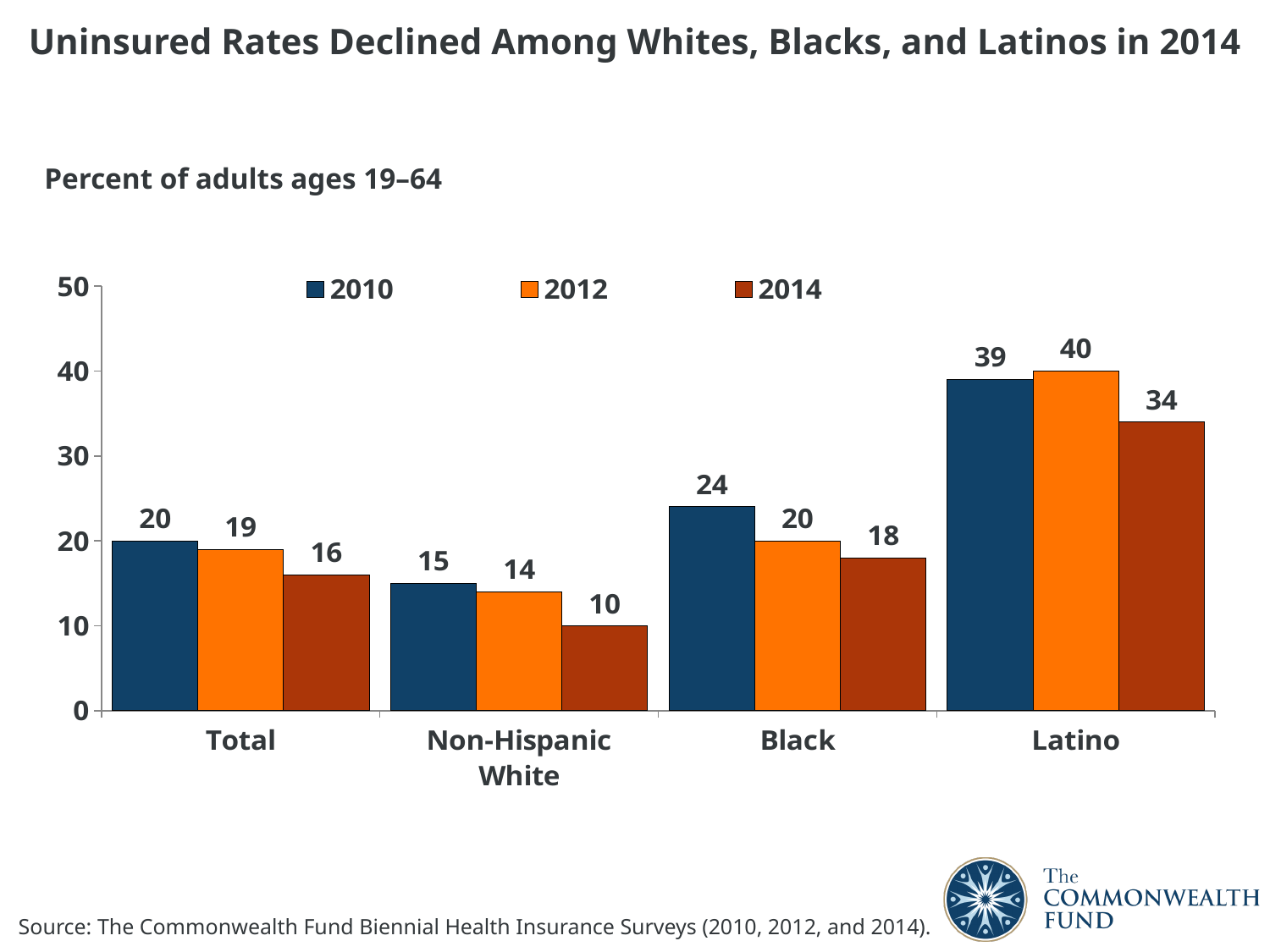
What is the 2012 value for Non-Hispanic White? 14 What is the 2014 value for Latino? 34 How many categories are shown on the x axis? 4 What is the title of the chart? Uninsured Rates Declined Among Whites, Blacks, and Latinos in 2014 What is the 2010 value for Black? 24 Which category has the lowest 2014 value? Non-Hispanic White Do the values for Non-Hispanic White rise or fall from 2010 to 2014? fall How many series does the legend list? 3 Which is larger for Latino, the 2010 value or the 2012 value? 2012 Which category has the highest 2012 value? Latino What is the difference between the 2010 and 2014 values for Black? 6 What kind of chart is shown on the slide? bar chart